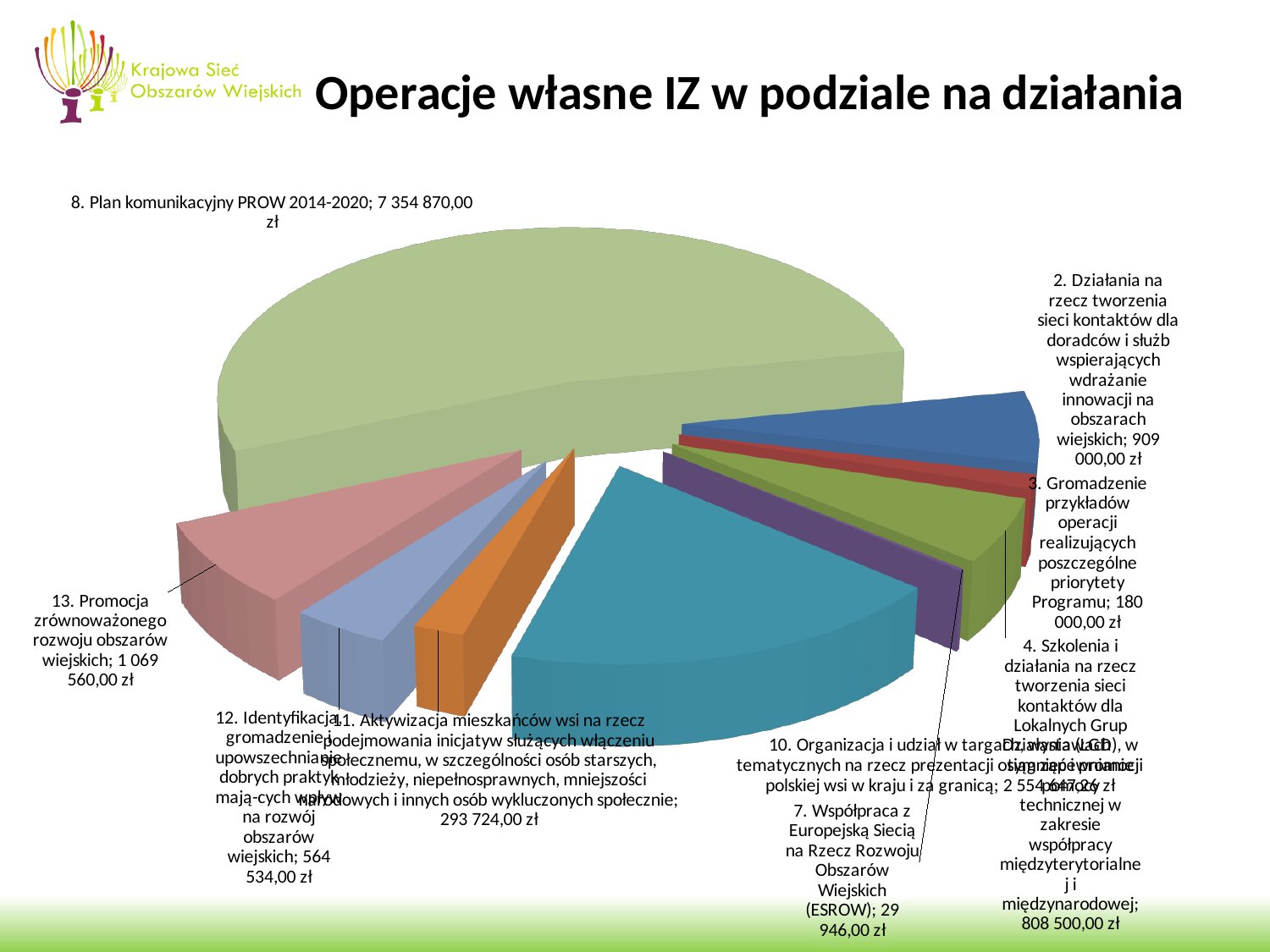
What is the value for '8. Plan komunikacyjny PROW 2014-2020'? 7 354 870,00 zł Which is larger: the value for category 2 (Działania na rzecz tworzenia sieci kontaktów dla doradców) or category 4 (Szkolenia i działania na rzecz tworzenia sieci kontaktów dla LGD)? category 2 (909 000,00 zł) How many slices does the pie chart have? 9 What is the value for '13. Promocja zrównoważonego rozwoju obszarów wiejskich'? 1 069 560,00 zł What is the value for '3. Gromadzenie przykładów operacji realizujących poszczególne priorytety Programu'? 180 000,00 zł What is the value for '7. Współpraca z Europejską Siecią na Rzecz Rozwoju Obszarów Wiejskich (ESROW)'? 29 946,00 zł What is the title of the chart? Operacje własne IZ w podziale na działania What is the value for '11. Aktywizacja mieszkańców wsi na rzecz podejmowania inicjatyw służących włączeniu społecznemu'? 293 724,00 zł What kind of chart is shown on the slide? pie chart What is the difference between the value for '13. Promocja zrównoważonego rozwoju obszarów wiejskich' and '12. Identyfikacja i gromadzenie i upowszechnianie dobrych praktyk'? 505 026,00 zł Which category has the largest slice of the pie? 8. Plan komunikacyjny PROW 2014-2020 Which category has the smallest slice of the pie? 7. Współpraca z Europejską Siecią na Rzecz Rozwoju Obszarów Wiejskich (ESROW)